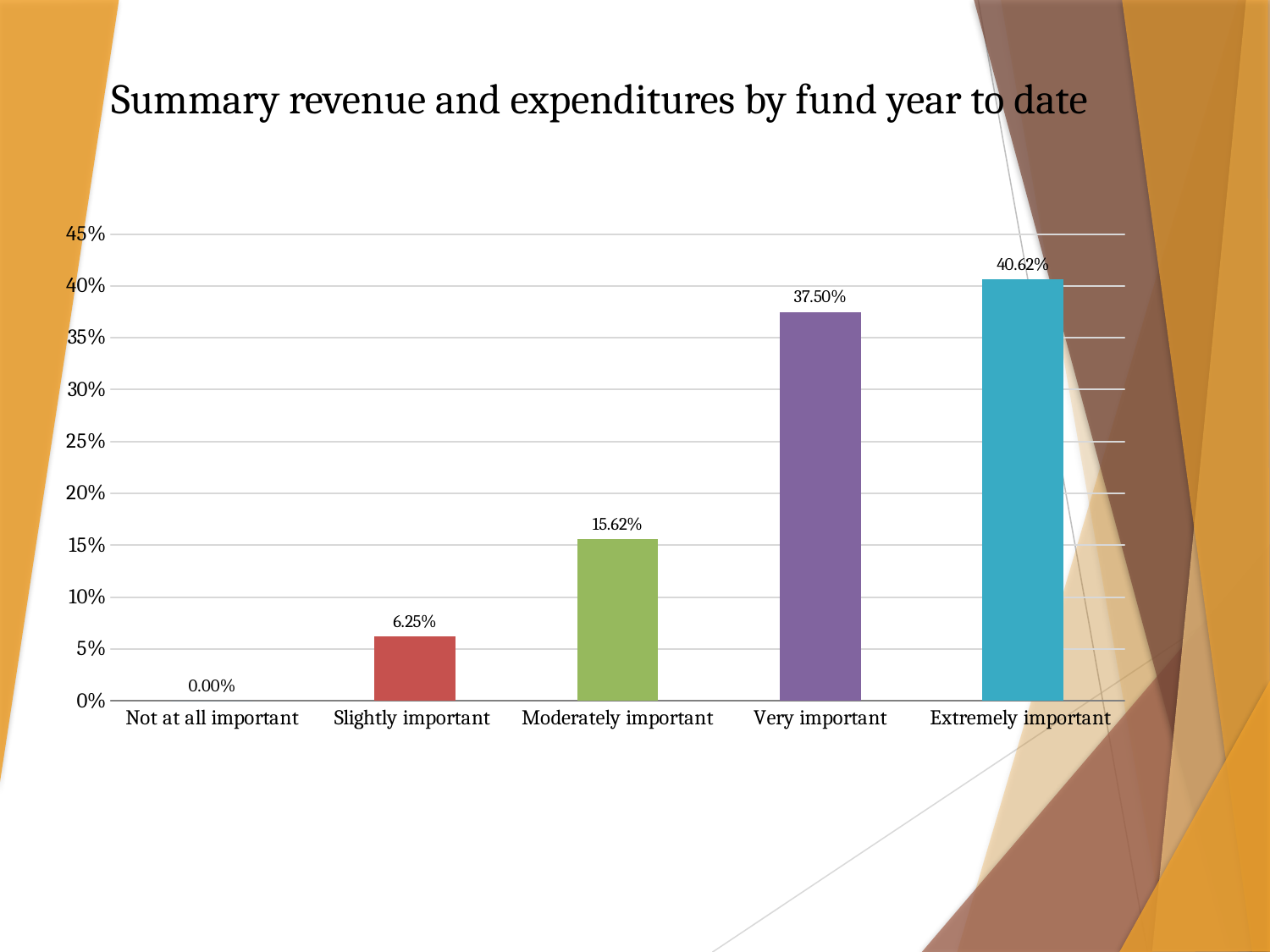
What is the value for Moderately important? 15.62% Do the values rise or fall from left to right along the x axis? rise What is the value for Extremely important? 40.62% What is the difference between the values for Extremely important and Very important? 3.12% Which category has the lowest value? Not at all important What is the value for Not at all important? 0.00% How many categories are shown on the x axis? 5 What kind of chart is shown on the slide? bar chart What is the value for Slightly important? 6.25% Which is larger, the value for Moderately important or the value for Slightly important? Moderately important Which category has the highest value? Extremely important Is the value for Very important greater or less than 35%? greater